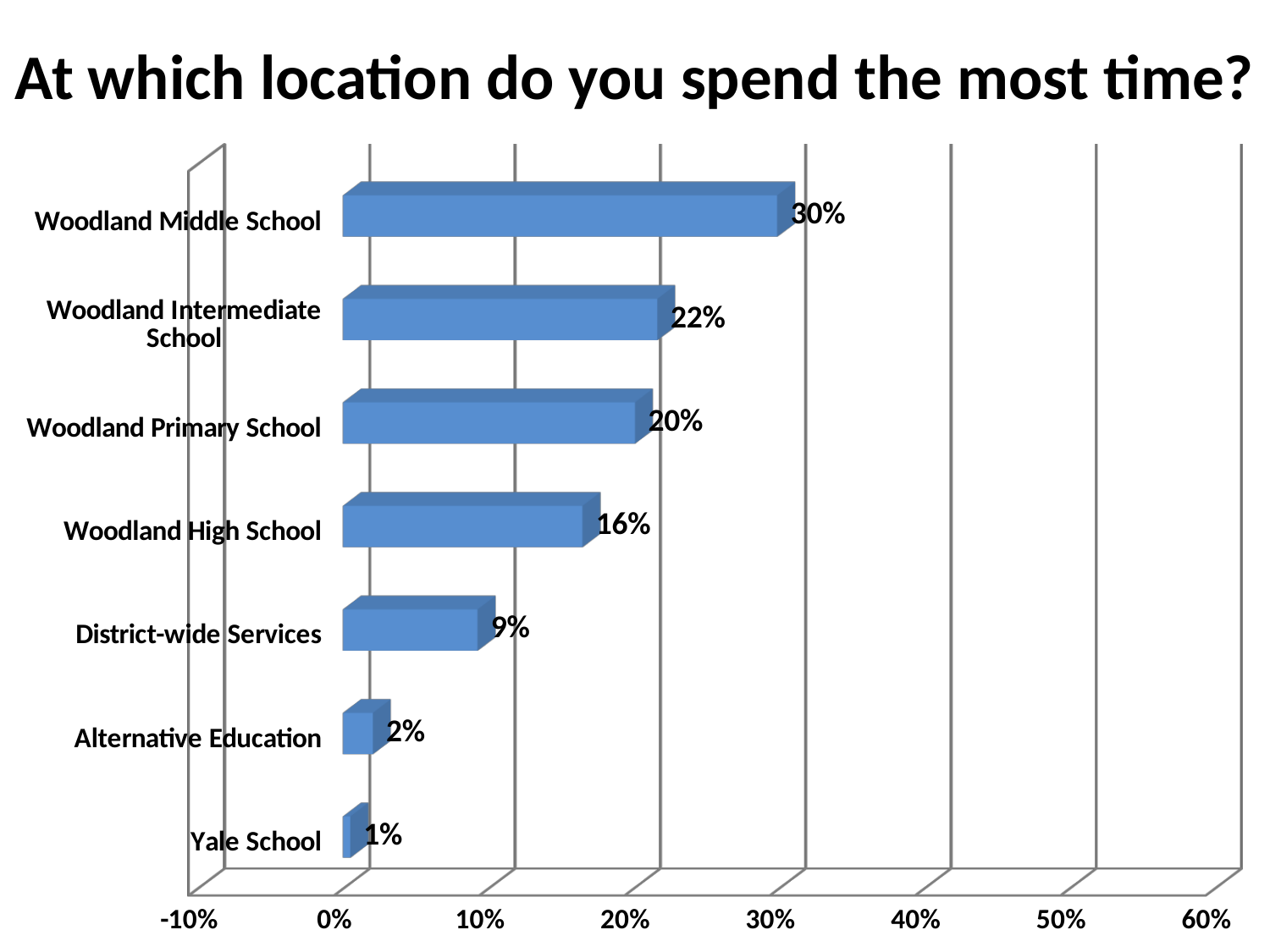
What kind of chart is shown on the slide? bar chart What is the difference between the values for Woodland Middle School and Woodland Intermediate School? 8% Which location has the highest value? Woodland Middle School What is the value shown for Woodland High School? 16% Which has a larger value, Woodland Intermediate School or Woodland Primary School? Woodland Intermediate School Which location has the lowest value? Yale School What is the value shown for District-wide Services? 9% How many locations are shown in the chart? 7 What is the difference between the values for Woodland Primary School and Woodland High School? 4% Is the value for Woodland High School greater or less than 20%? less What is the title of the chart? At which location do you spend the most time? What percentage of respondents spend the most time at Woodland Middle School? 30%